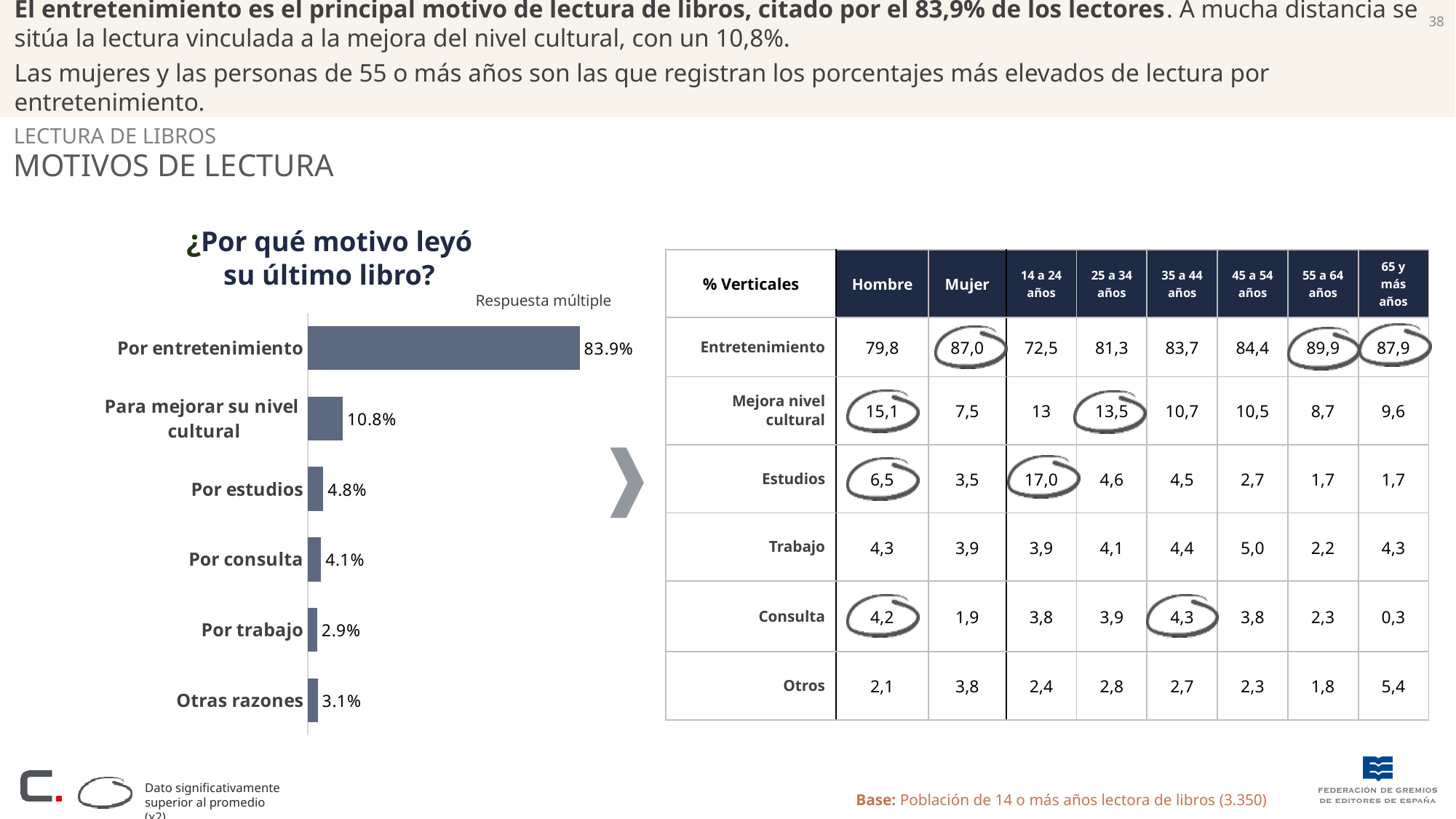
What note appears under the title of the bar chart? Respuesta múltiple What is the value for 'Por entretenimiento' in the chart '¿Por qué motivo leyó su último libro?'? 83.9% How many categories are shown in the chart '¿Por qué motivo leyó su último libro?'? 6 What is the difference between the values for 'Por entretenimiento' and 'Para mejorar su nivel cultural' in the bar chart? 73.1% Which is larger in the bar chart, 'Por estudios' or 'Por trabajo'? Por estudios What is the value for 'Para mejorar su nivel cultural' in the bar chart? 10.8% What is the value for 'Otras razones' in the bar chart? 3.1% What is the value for 'Por consulta' in the bar chart? 4.1% What is the difference between the values for 'Por estudios' and 'Por consulta' in the bar chart? 0.7% What kind of chart is '¿Por qué motivo leyó su último libro?'? Bar chart Which category has the lowest value in the bar chart? Por trabajo Which category has the highest value in the chart '¿Por qué motivo leyó su último libro?'? Por entretenimiento